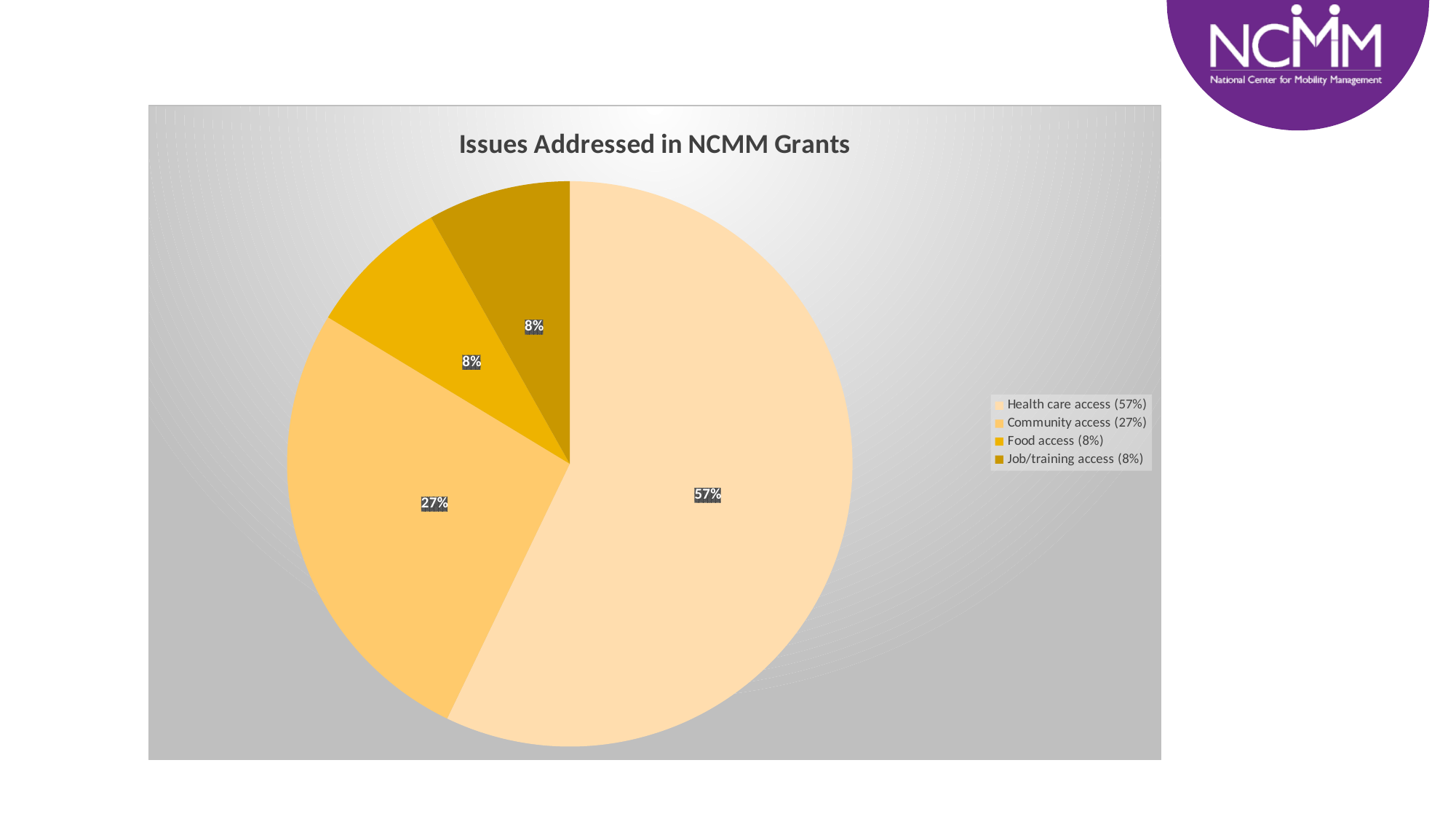
What share of the pie does Health care access represent? 57% What share of the pie does Food access represent? 8% What kind of chart is shown on the slide? pie chart What is the combined share of Food access and Job/training access? 16% What is the difference between the Health care access share and the Community access share? 30% What share of the pie does Job/training access represent? 8% What is the title of the chart? Issues Addressed in NCMM Grants How many categories does the legend list? 4 Is the share for Health care access greater or less than 50%? greater Which is larger, the share for Community access or the share for Food access? Community access Which category has the largest slice of the pie? Health care access